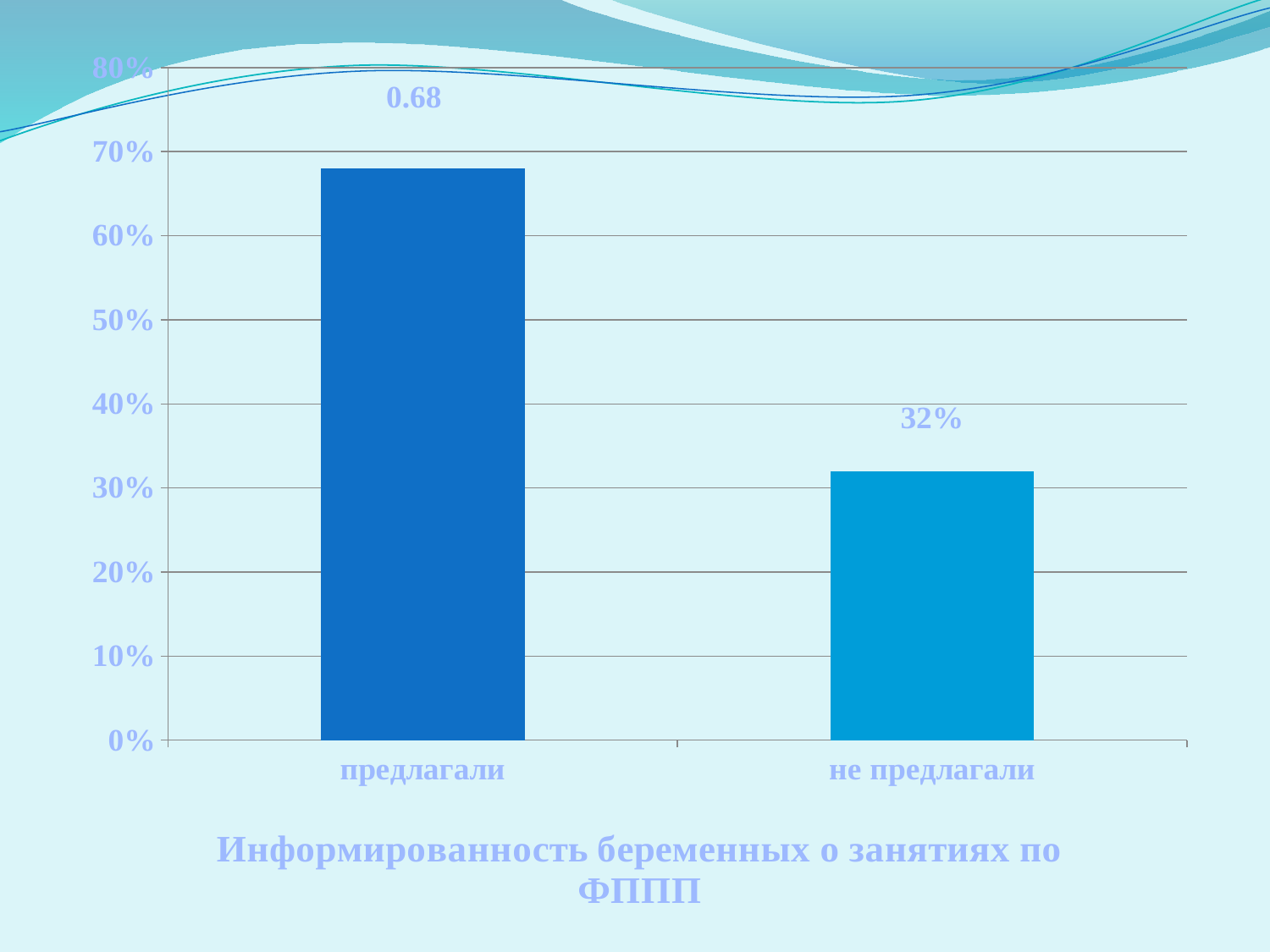
Which category has the highest bar? предлагали Do the bar values rise or fall from left to right along the x axis? fall What is the data label shown on the bar for "не предлагали"? 32% Which bar is taller, "предлагали" or "не предлагали"? предлагали Is the value for "не предлагали" greater or less than 40%? less What is the title of the chart? Информированность беременных о занятиях по ФППП Is the value for "предлагали" greater or less than 60%? greater Which category has the lowest bar? не предлагали What kind of chart is shown on the slide? bar chart What is the data label shown on the bar for "предлагали"? 0.68 How many categories are shown on the x axis? 2 What is the highest tick label on the vertical axis? 80%